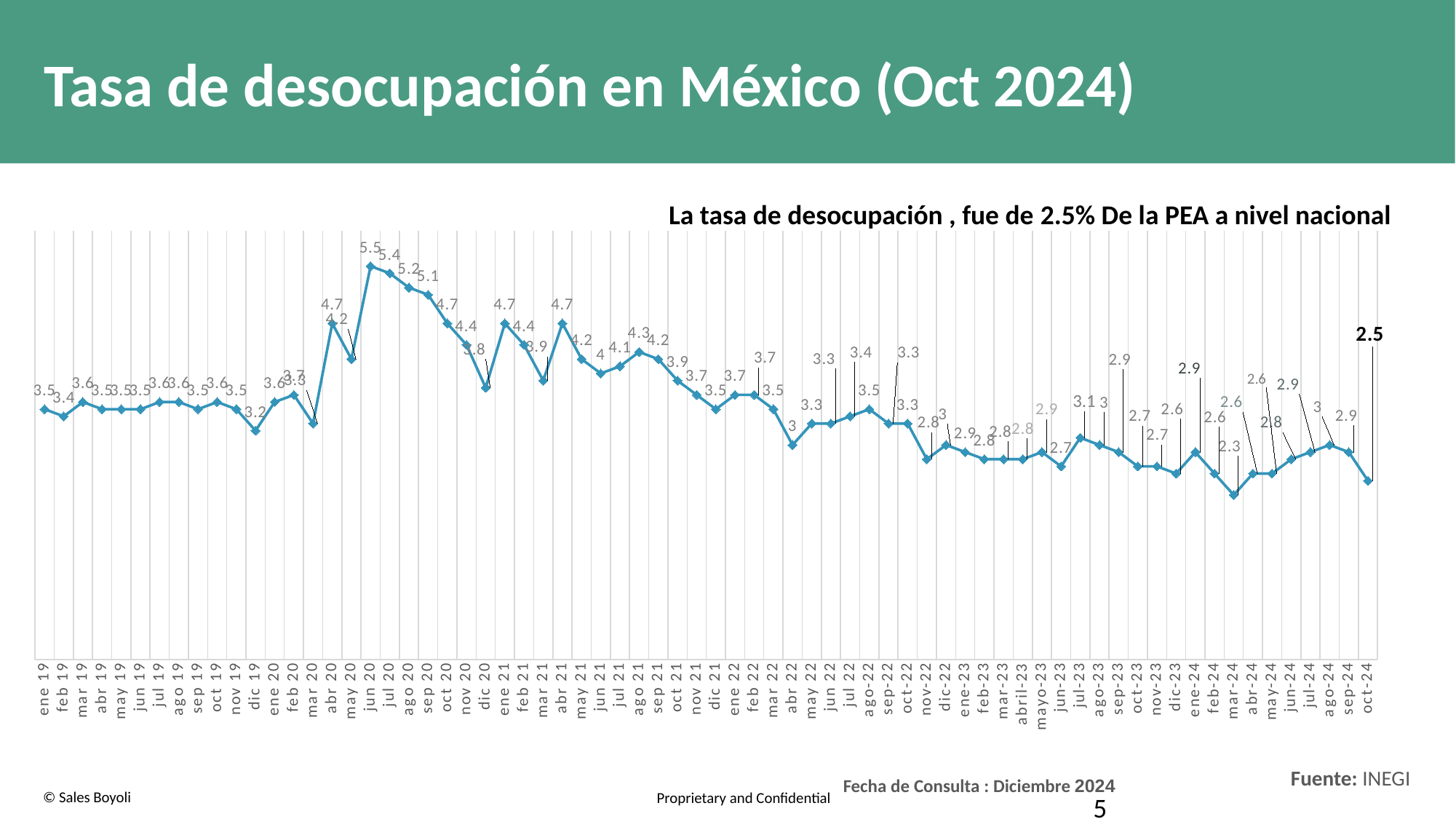
What is the unemployment rate shown for oct-24? 2.5 What value is plotted for jun 20? 5.5 Do the values rise or fall from jun 20 to dic 20? Fall What is the difference between the value for jun 20 and the value for oct-24? 3 Which month has the highest unemployment rate on the chart? jun 20 Which is larger, the value for abr 20 or the value for may 20? abr 20 What is the title of the slide? Tasa de desocupación en México (Oct 2024) What is the difference between the value for abr-24 and the value for mar-24? 0.3 What value is plotted for dic 19? 3.2 Which month has the lowest unemployment rate on the chart? mar-24 How many monthly data points are plotted on the chart? 70 What kind of chart is shown on the slide? Line chart